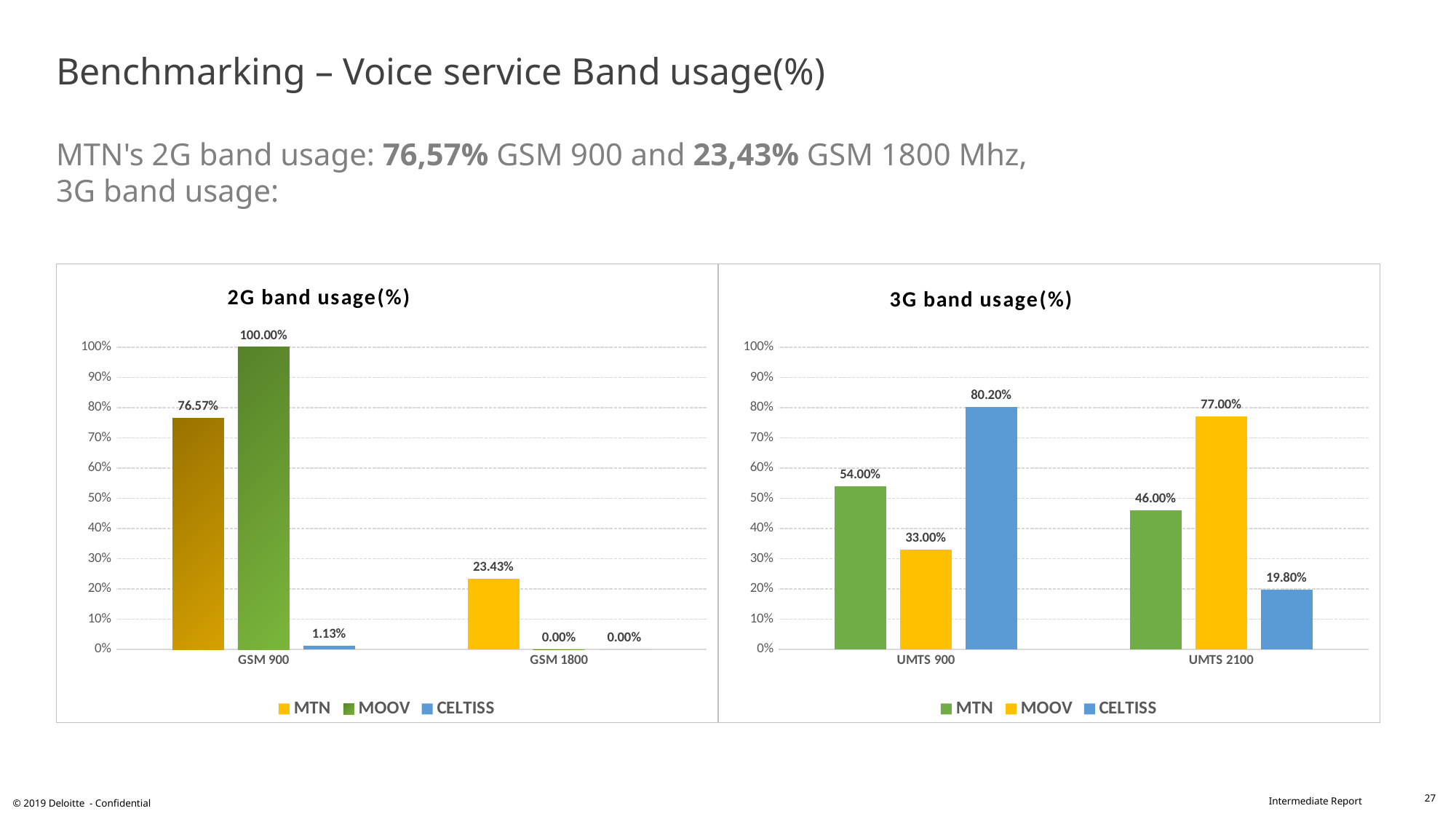
In the 2G band usage(%) chart, how many series does the legend list? 3 In the 3G band usage(%) chart, what is the difference between MTN's values at UMTS 900 and UMTS 2100? 8.00% In the 3G band usage(%) chart, what is the value for MOOV at UMTS 2100? 77.00% In the 3G band usage(%) chart, what is the value for CELTISS at UMTS 900? 80.20% In the 2G band usage(%) chart, what is the value for CELTISS at GSM 900? 1.13% In the 2G band usage(%) chart, what is the value for MTN at GSM 900? 76.57% In the 3G band usage(%) chart, is the value for MOOV at UMTS 900 larger or smaller than the value for MTN at UMTS 900? smaller In the 2G band usage(%) chart, which operator has the highest value at GSM 900? MOOV In the 3G band usage(%) chart, which operator has the lowest value at UMTS 2100? CELTISS What type of chart is the 3G band usage(%) chart? bar chart In the 2G band usage(%) chart, what is the difference between MOOV and MTN at GSM 900? 23.43% In the 3G band usage(%) chart, how many categories are shown on the x axis? 2